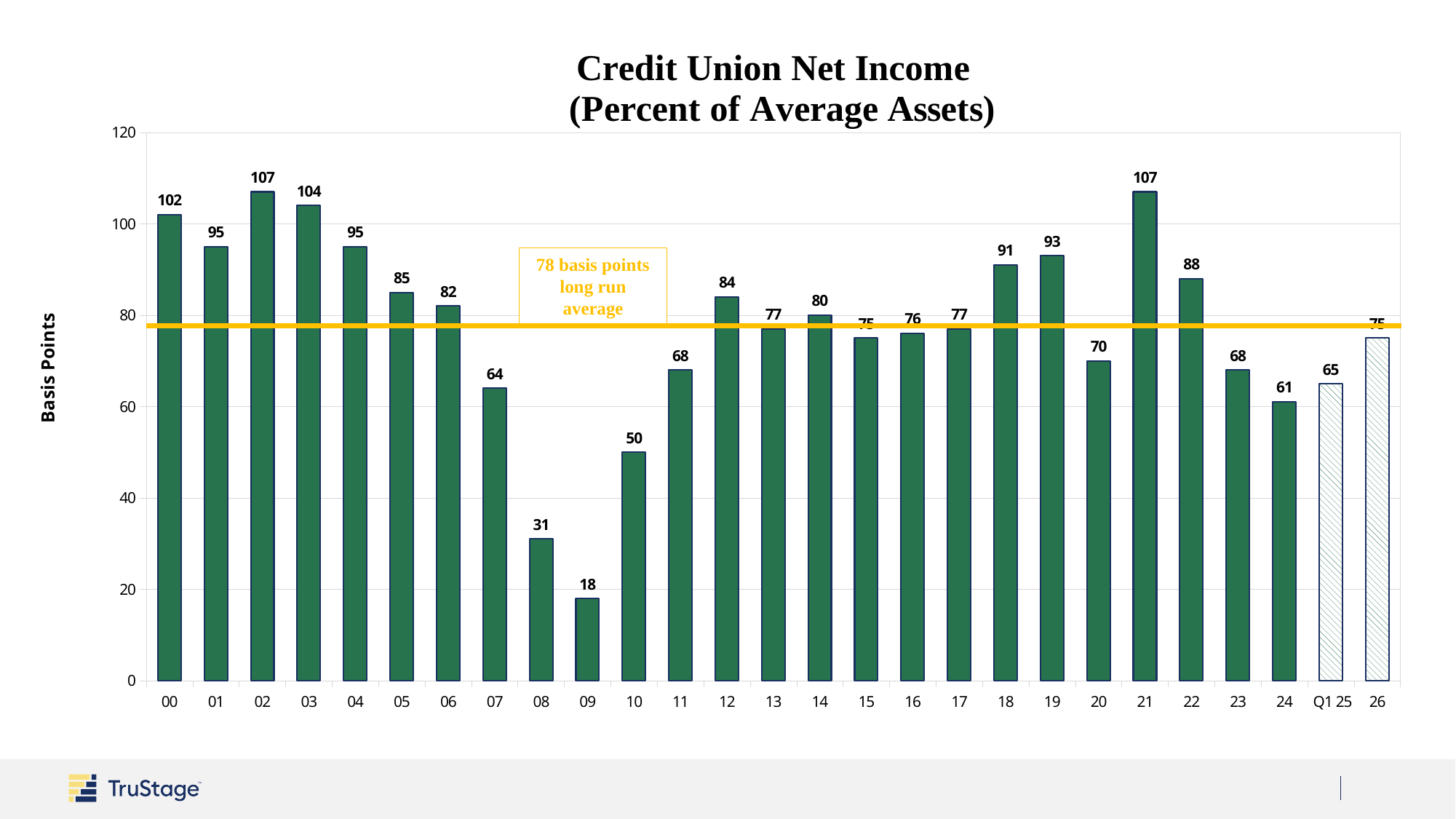
What is the difference between the values for 00 and 24? 41 What is the highest value shown on the chart? 107 How many bars are plotted on the chart? 27 What is the difference between the values for 08 and 09? 13 What is the value for Q1 25? 65 What kind of chart is this? bar chart What is the value for 09? 18 Which is larger, the value for 18 or the value for 19? 19 What is the value for 21? 107 Which year has the lowest value? 09 Do the values rise or fall from 06 to 09? fall What long run average does the horizontal line on the chart represent? 78 basis points